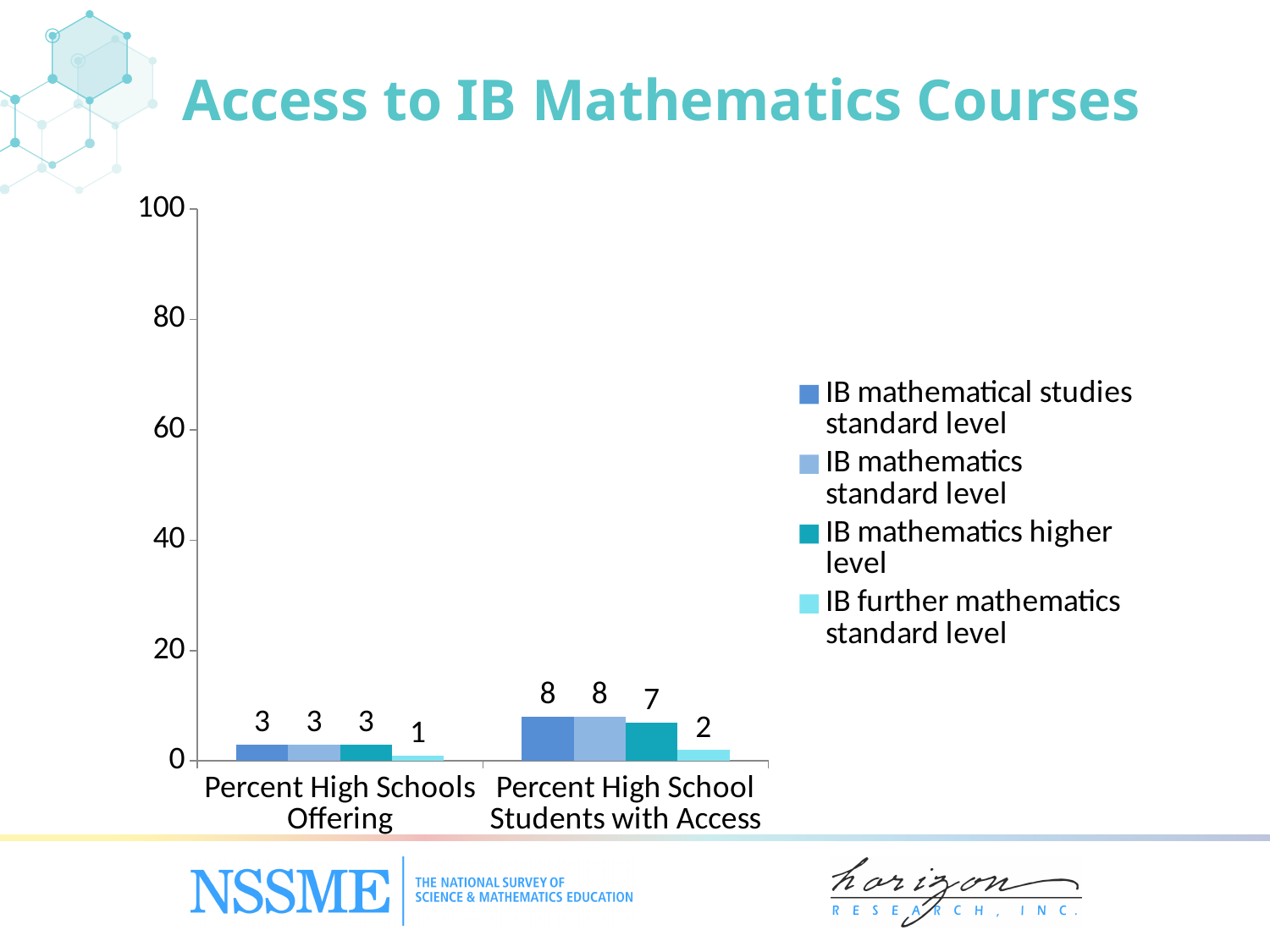
Is the value for IB mathematical studies standard level in the Percent High School Students with Access category greater or less than 20? less What is the value for IB mathematics higher level in the Percent High School Students with Access category? 7 What kind of chart is shown on the slide? bar chart What is the value for IB further mathematics standard level in the Percent High Schools Offering category? 1 What is the value for IB mathematics standard level in the Percent High Schools Offering category? 3 What is the difference between the IB mathematics higher level values for Percent High School Students with Access and Percent High Schools Offering? 4 How many series does the legend list? 4 What is the title of the slide? Access to IB Mathematics Courses Which series has the lowest value in the Percent High School Students with Access category? IB further mathematics standard level Which is larger: the IB further mathematics standard level value for Percent High Schools Offering or for Percent High School Students with Access? Percent High School Students with Access How many categories are shown on the x axis? 2 What is the value for IB mathematical studies standard level in the Percent High School Students with Access category? 8